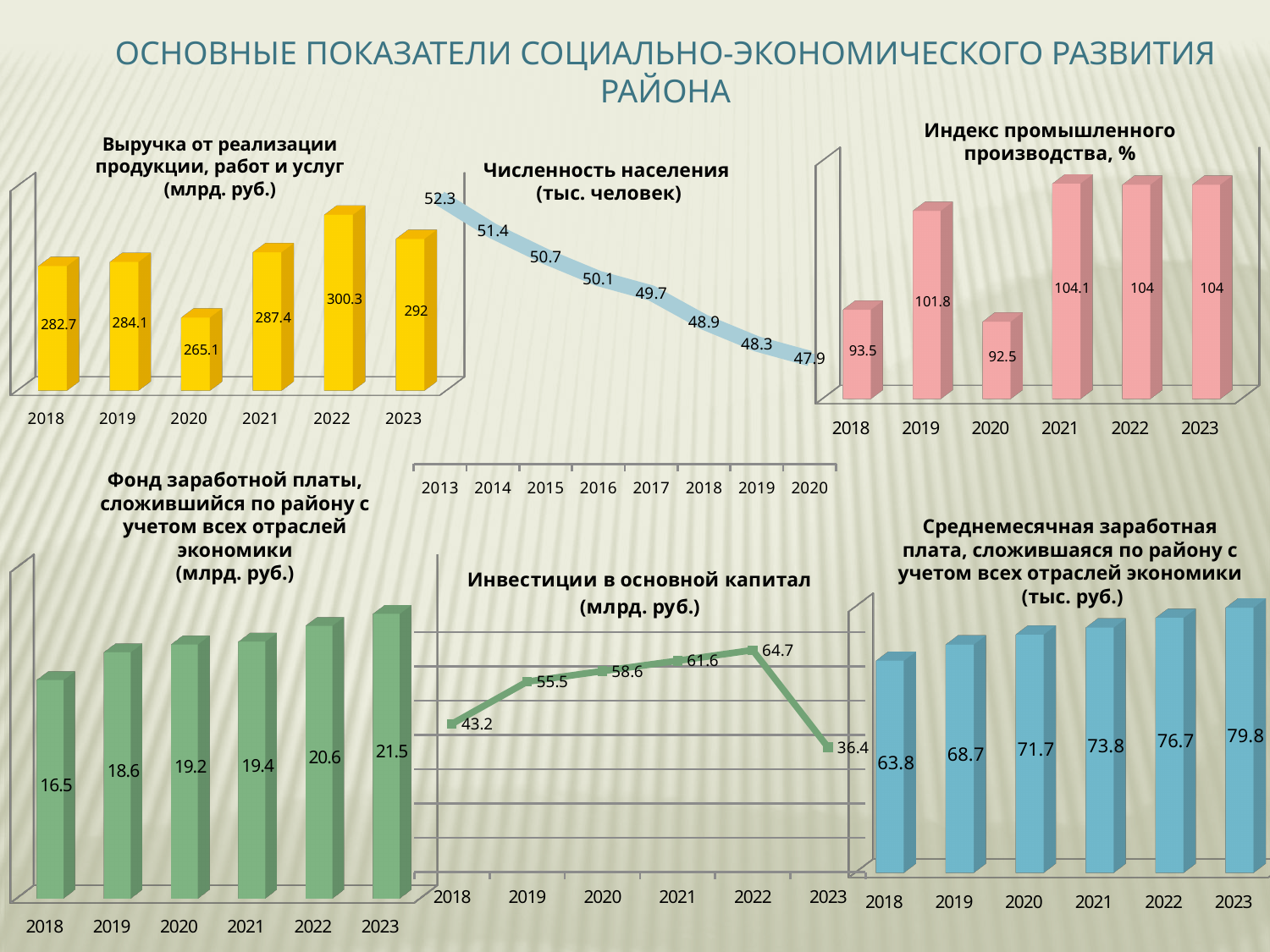
In the chart 'Среднемесячная заработная плата, сложившаяся по району с учетом всех отраслей экономики (тыс. руб.)', which is larger, the value for 2020 or the value for 2021? 2021 In the chart 'Инвестиции в основной капитал (млрд. руб.)', which year has the highest value? 2022 In the chart 'Численность населения (тыс. человек)', how many data points are plotted? 8 In the chart 'Фонд заработной платы, сложившийся по району с учетом всех отраслей экономики (млрд. руб.)', what is the difference between the 2023 and 2018 values? 5 In the chart 'Индекс промышленного производства, %', what is the value for 2019? 101.8 In the chart 'Выручка от реализации продукции, работ и услуг (млрд. руб.)', what is the value for 2022? 300.3 In the chart 'Численность населения (тыс. человек)', what is the value for 2013? 52.3 In the chart 'Индекс промышленного производства, %', which year has the highest value? 2021 In the chart 'Инвестиции в основной капитал (млрд. руб.)', what is the value for 2023? 36.4 In the chart 'Выручка от реализации продукции, работ и услуг (млрд. руб.)', which year has the lowest value? 2020 What kind of chart is 'Инвестиции в основной капитал (млрд. руб.)'? line chart In the chart 'Численность населения (тыс. человек)', do the values rise or fall from 2013 to 2020? fall